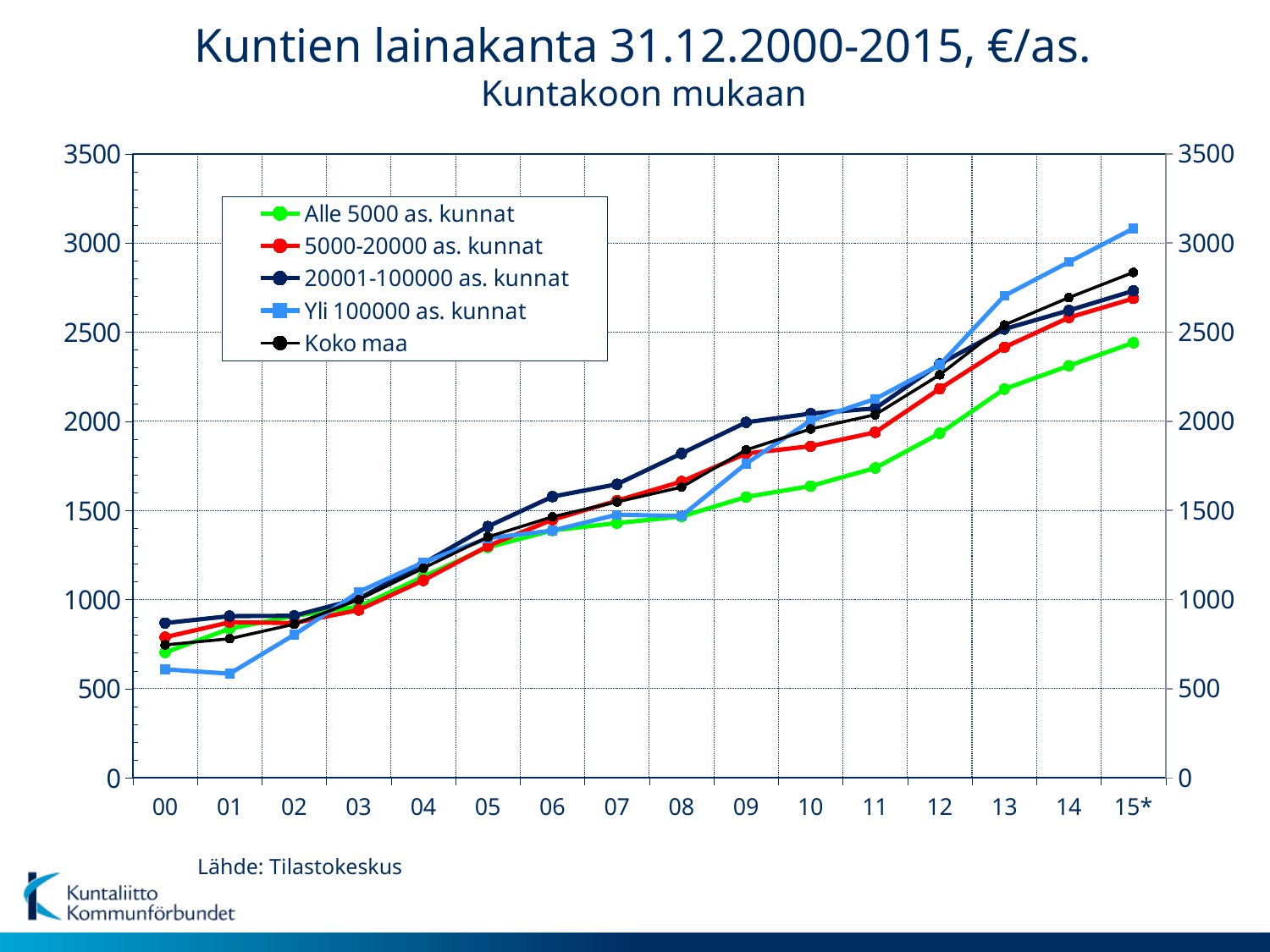
Which series has the lowest value in 00? Yli 100000 as. kunnat Is the value for Yli 100000 as. kunnat in 00 greater or less than 1000? less What kind of chart is shown on the slide? line chart Is the value for Yli 100000 as. kunnat in 13 greater or less than 2500? greater How many years are shown along the x axis? 16 How many series does the legend list? 5 Which series has the lowest value in 15*? Alle 5000 as. kunnat In 08, which is larger: the value for 20001-100000 as. kunnat or for Alle 5000 as. kunnat? 20001-100000 as. kunnat What colour is the line for Alle 5000 as. kunnat? green Is the value for Alle 5000 as. kunnat in 10 greater or less than 1500? greater Which series has the highest value in 15*? Yli 100000 as. kunnat Do the values for Koko maa rise or fall from 00 to 15*? rise